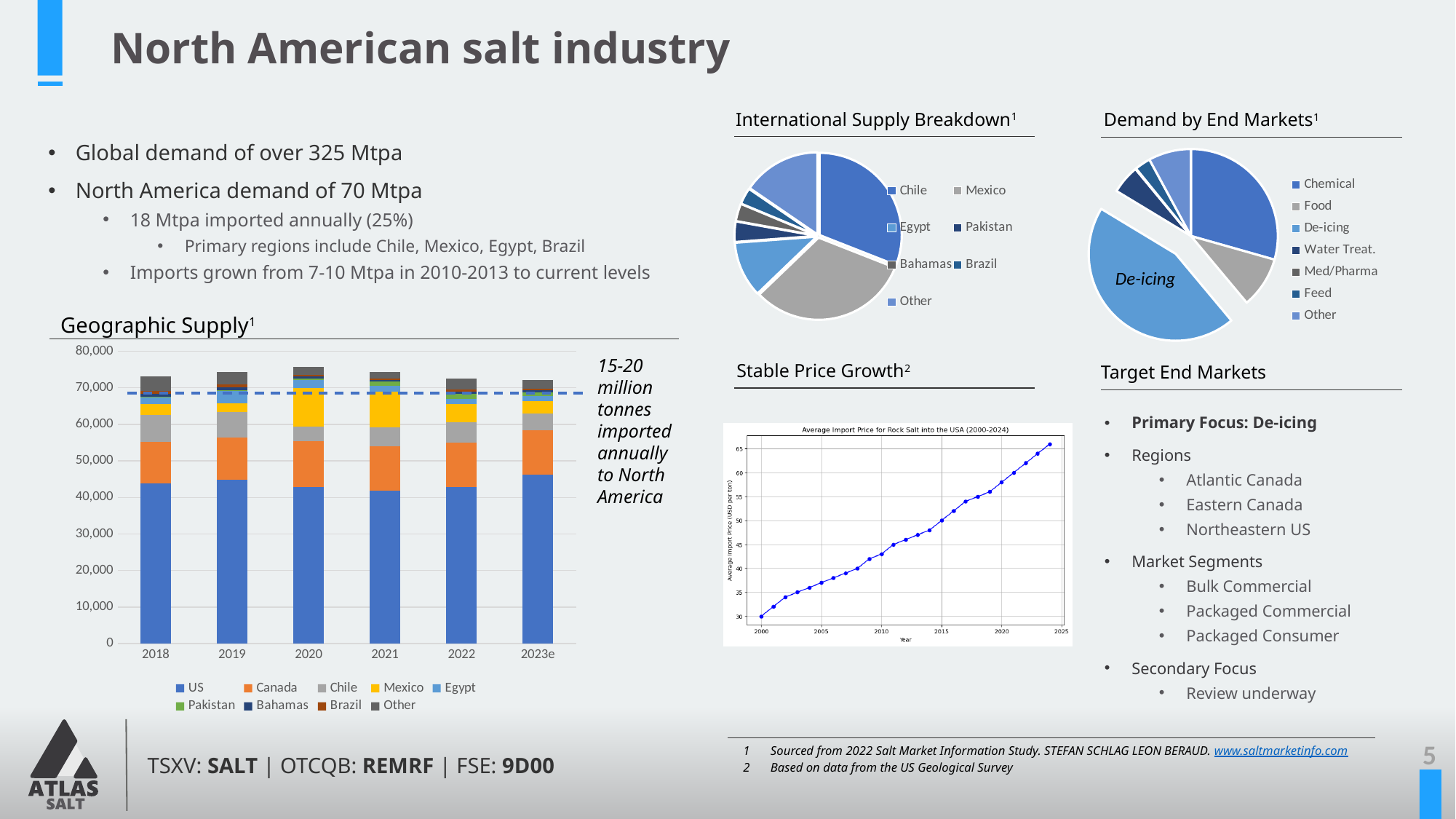
In the Stable Price Growth chart, is the average import price in 2020 greater or less than 55? greater How many entries does the legend of the International Supply Breakdown chart list? 7 What kind of chart is the Geographic Supply chart? stacked bar chart In the Stable Price Growth chart, do the values rise or fall from 2000 to 2024? rise How many years are shown on the x axis of the Geographic Supply chart? 6 In the Geographic Supply chart, which series forms the largest segment of each bar? US In the Demand by End Markets chart, which end market has the largest slice? De-icing In the Geographic Supply chart, is the US value for 2018 greater or less than 40,000? greater In the Geographic Supply chart, is the total stacked bar for 2020 greater or less than 70,000? greater In the Demand by End Markets chart, which slice is larger, De-icing or Food? De-icing How many series does the legend of the Geographic Supply chart list? 9 What kind of chart is the International Supply Breakdown chart? pie chart